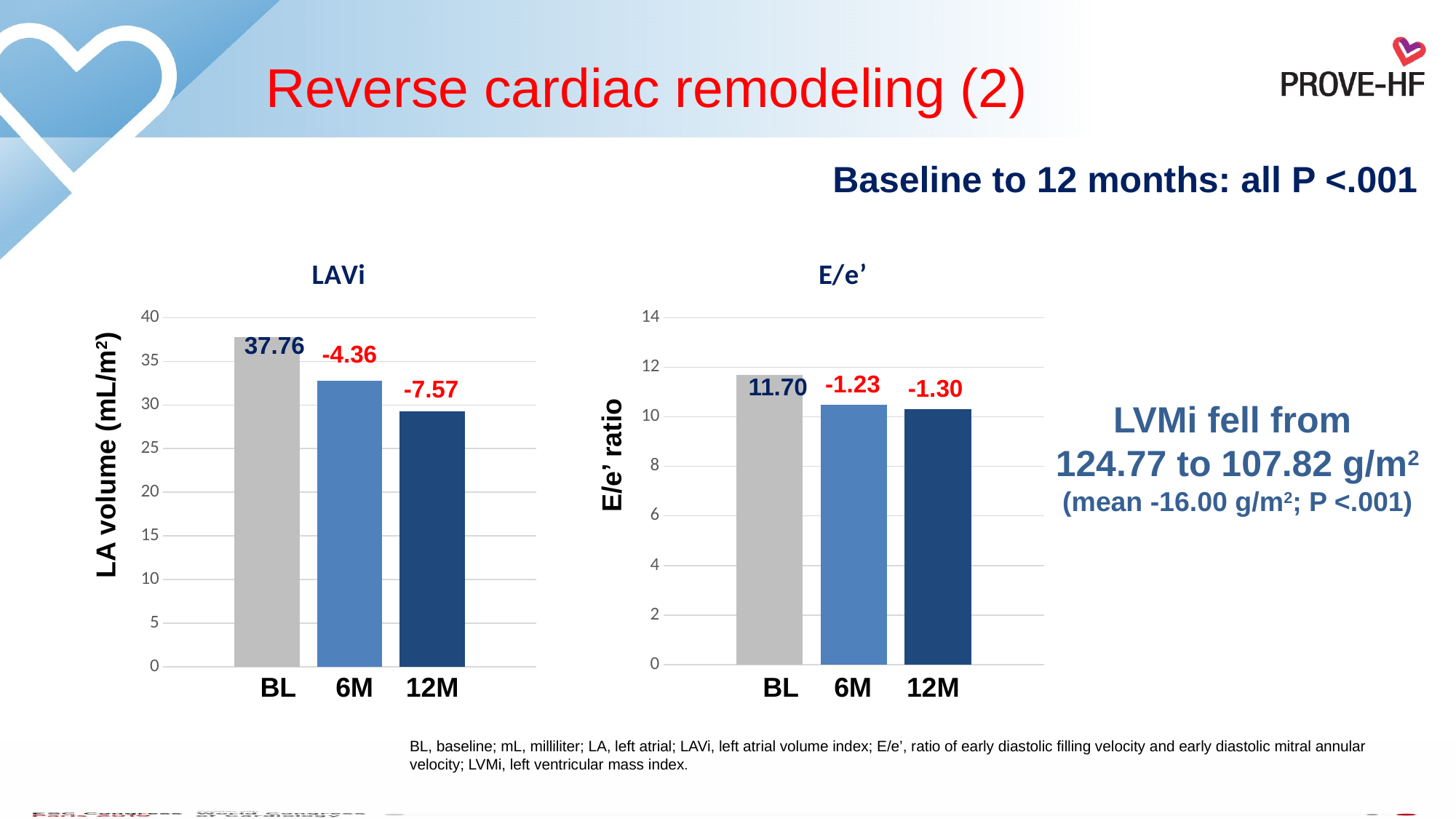
In the E/e' chart, is the value for 12M greater or less than 12? less In the LAVi chart, what change is labeled above the 6M bar? -4.36 In the LAVi chart, what change is labeled above the 12M bar? -7.57 How many time points are plotted in the LAVi chart? 3 In the E/e' chart, what is the value labeled on the BL bar? 11.70 In the LAVi chart, what is the value labeled on the BL bar? 37.76 In the E/e' chart, what change is labeled above the 12M bar? -1.30 In the LAVi chart, which time point has the highest bar? BL In the E/e' chart, which time point has the lowest bar? 12M In the E/e' chart, what change is labeled above the 6M bar? -1.23 Do the bar heights in the E/e' chart rise or fall from BL to 12M? fall In the LAVi chart, is the value for 6M greater or less than 30? greater